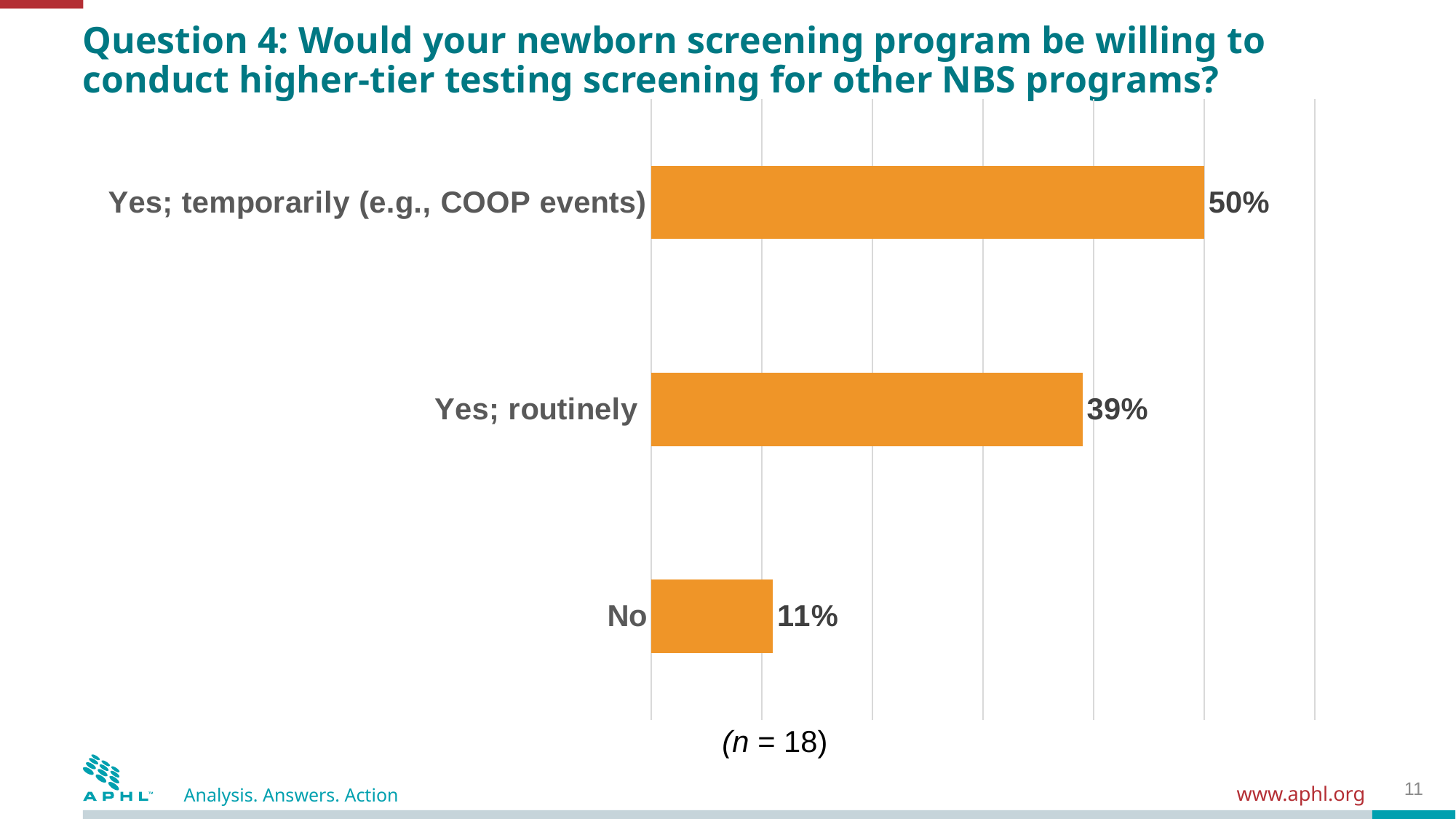
What kind of chart is shown on the slide? Bar chart What colour are the bars in the chart? Orange What percentage of respondents answered "No"? 11% Which is larger, the percentage for "Yes; routinely" or for "No"? Yes; routinely What percentage of respondents answered "Yes; routinely"? 39% What is the difference in percentage points between "Yes; temporarily (e.g., COOP events)" and "Yes; routinely"? 11% Which response category has the highest percentage? Yes; temporarily (e.g., COOP events) Which response category has the lowest percentage? No What is the sample size (n) noted below the chart? 18 How many response categories are shown in the chart? 3 What percentage of respondents answered "Yes; temporarily (e.g., COOP events)"? 50% What is the difference in percentage points between "Yes; routinely" and "No"? 28%